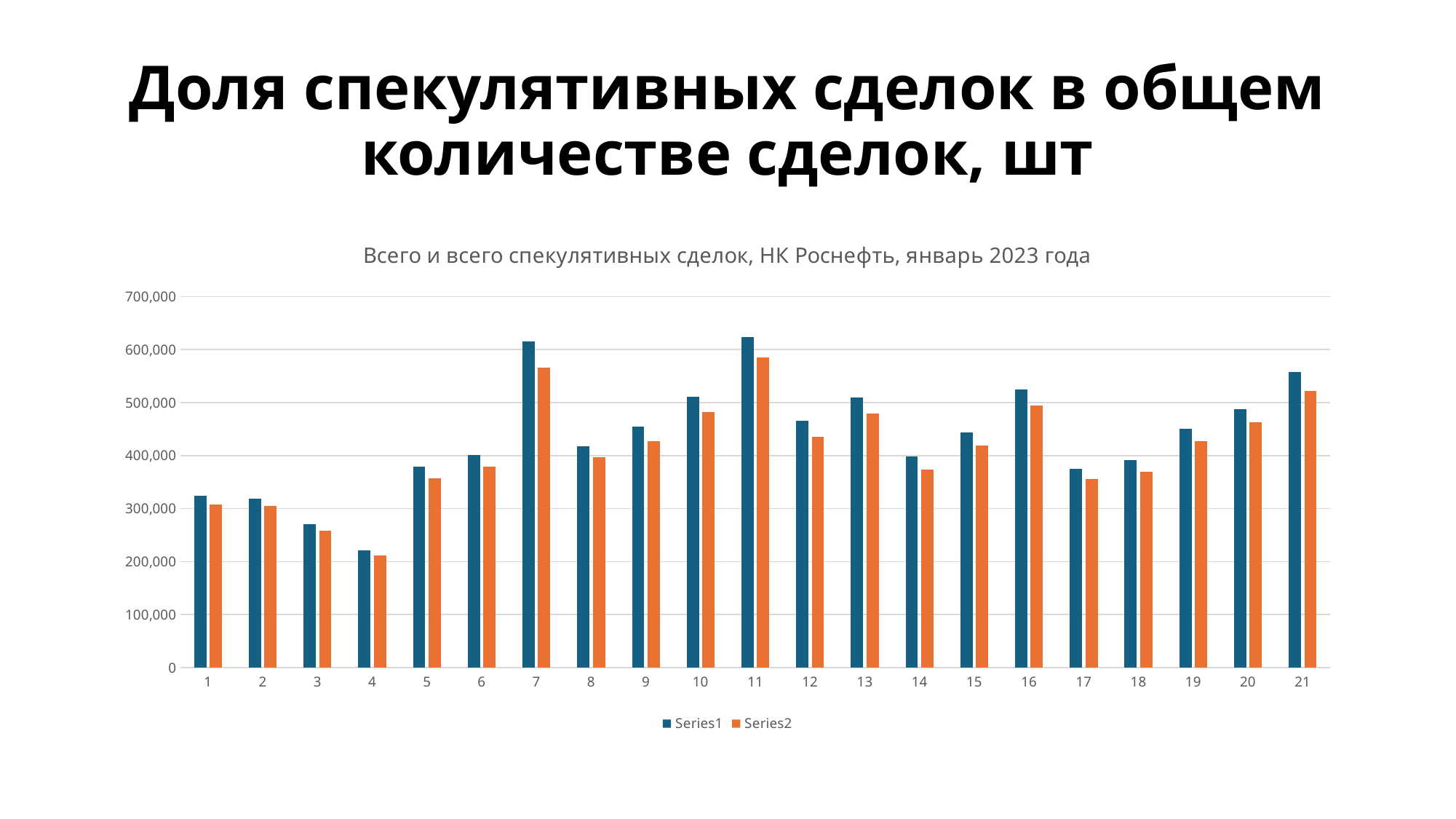
Which category has the lowest value for Series1? 4 How many categories are shown on the x axis? 21 What is the subtitle printed above the chart? Всего и всего спекулятивных сделок, НК Роснефть, январь 2023 года Is the value for Series1 at category 4 greater or less than 300,000? less How many series does the legend list? 2 Is the value for Series1 at category 21 greater or less than 500,000? greater Which category has the highest value for Series2? 11 Which is larger for Series1: the value at category 7 or the value at category 21? Category 7 Do the Series1 values rise or fall from category 1 to category 4? Fall What kind of chart is shown on the slide? Bar chart Is the value for Series1 at category 7 greater or less than 600,000? greater